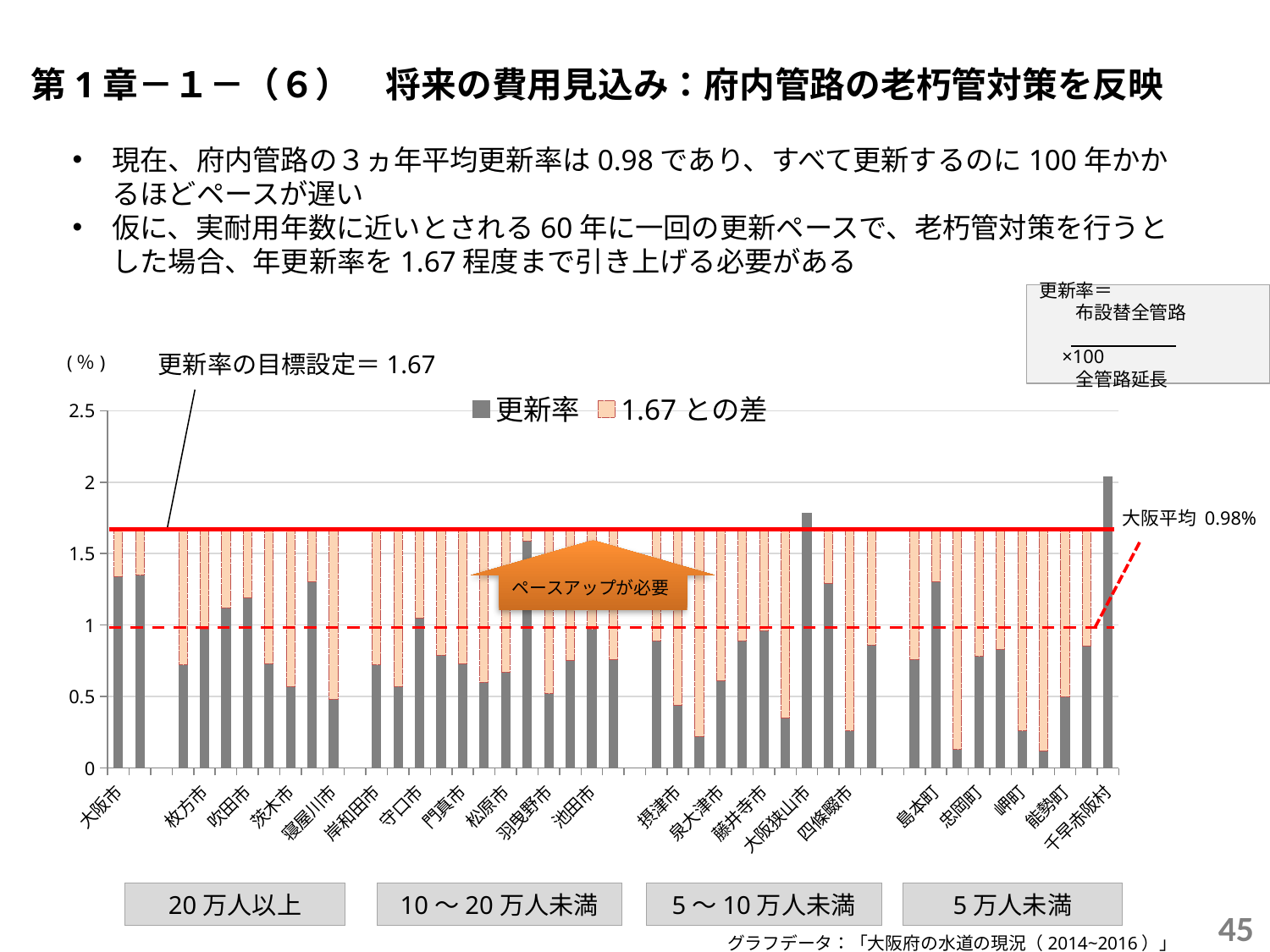
Is the 更新率 value for 羽曳野市 greater or less than 1? less Is the 更新率 value for 茨木市 greater or less than 1? less How many series does the chart legend list? 2 What target value for 更新率 is marked by the solid red line on the chart? 1.67 What is the maximum value shown on the chart's vertical axis? 2.5 Is the 更新率 value for 千早赤阪村 greater or less than 1.5? greater Which municipality has the highest 更新率 bar on the chart? 千早赤阪村 What are the two series named in the chart legend? 更新率 and 1.67との差 What kind of chart is shown on the slide? bar chart What value is given for 大阪平均 on the chart? 0.98%